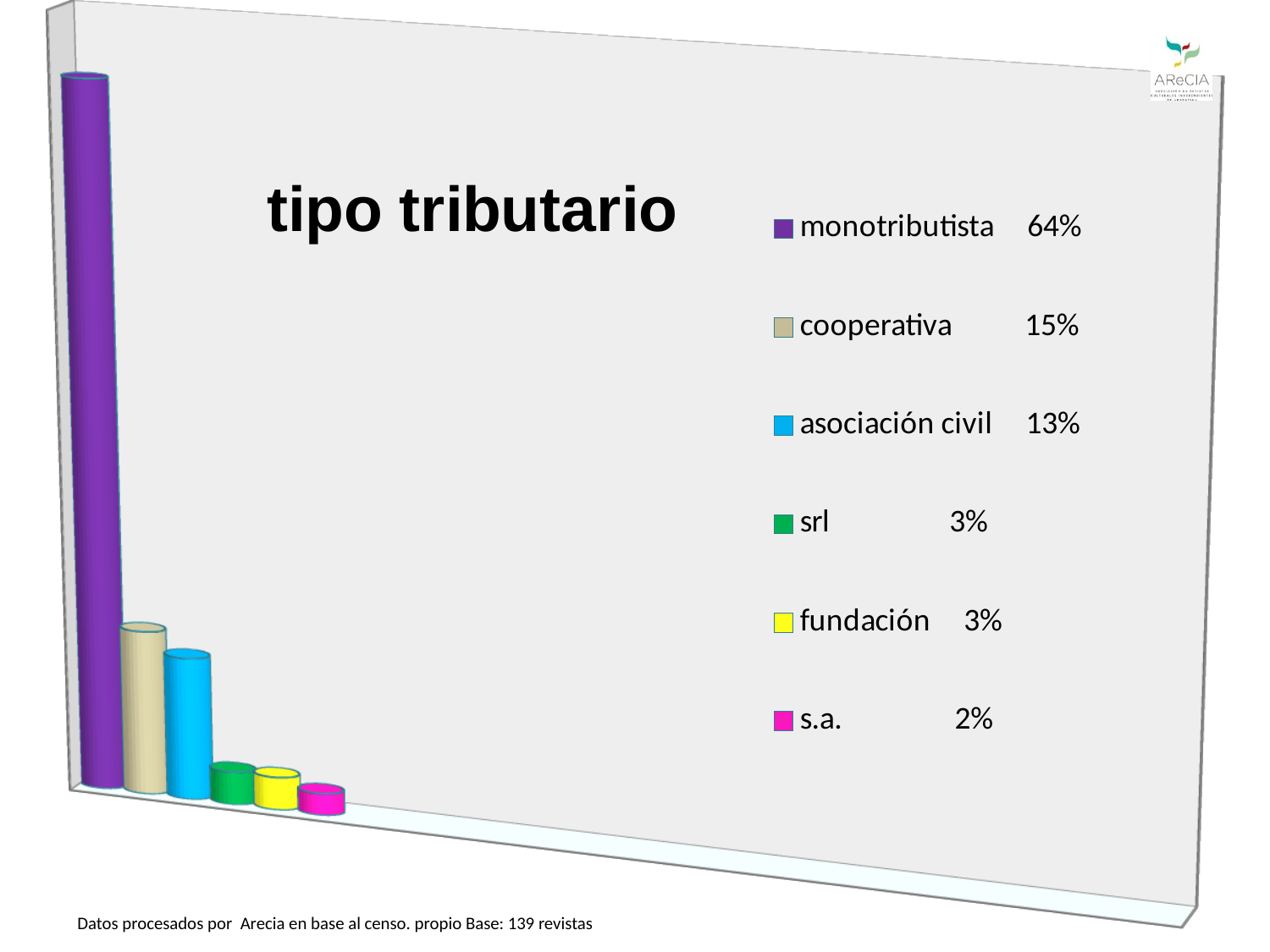
What is the value for s.a.? 2% What kind of chart is shown on the slide? bar chart How many entries does the legend list? 6 What is the value for monotributista? 64% Which is larger, the value for cooperativa or the value for asociación civil? cooperativa What is the title of the chart? tipo tributario What is the difference between the values for monotributista and cooperativa? 49% What is the value for asociación civil? 13% Which category has the highest value? monotributista What is the value for cooperativa? 15% Which category has the lowest value? s.a. How many categories are shown in the chart? 6